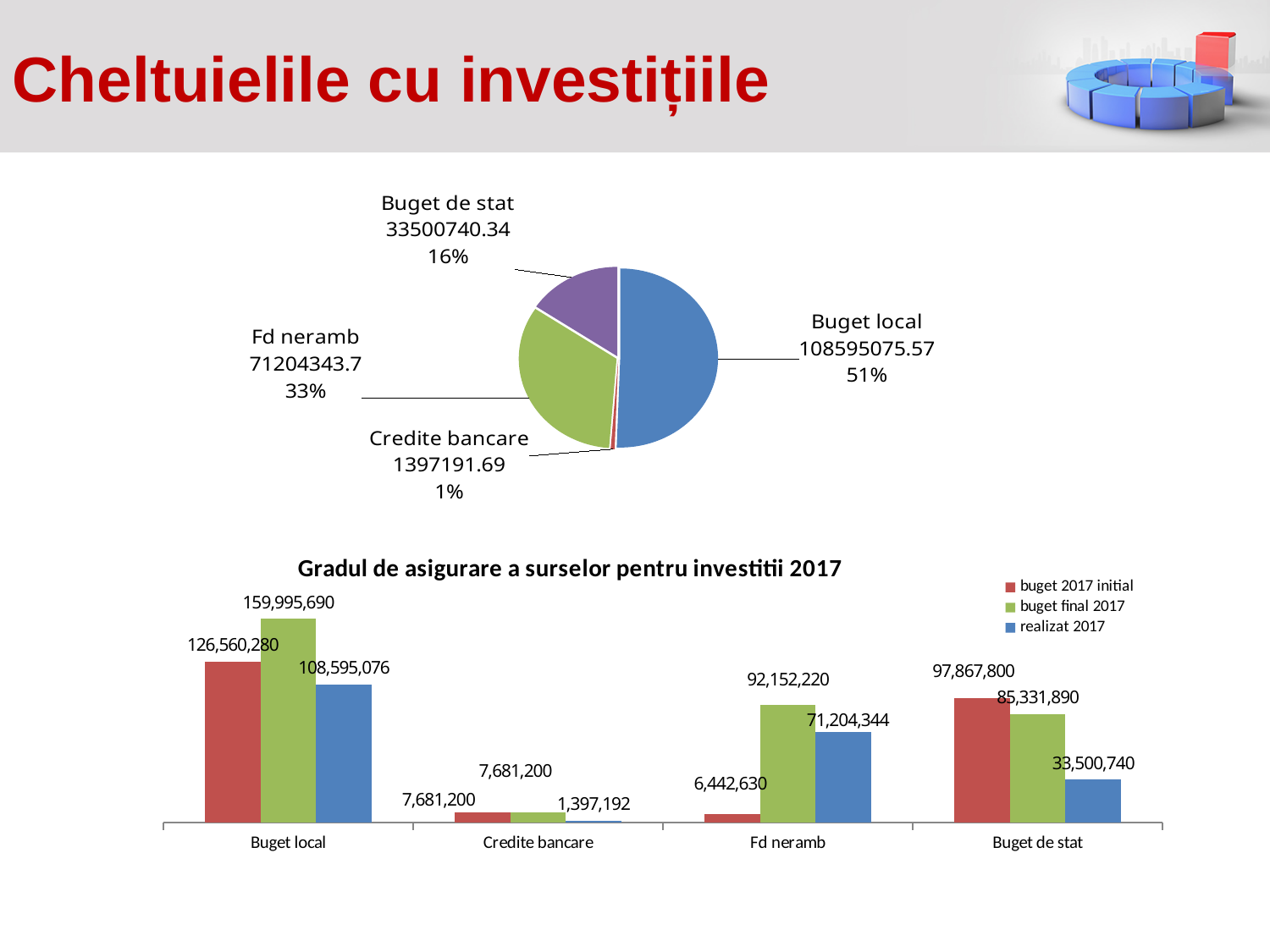
In the chart 'Gradul de asigurare a surselor pentru investitii 2017', what is the value of 'realizat 2017' for Fd neramb? 71,204,344 What kind of chart is 'Gradul de asigurare a surselor pentru investitii 2017'? bar chart In the pie chart at the top of the slide, what is the value for Buget local? 108595075.57 In the chart 'Gradul de asigurare a surselor pentru investitii 2017', what is the difference between 'buget final 2017' and 'realizat 2017' for Buget de stat? 51,831,150 In the pie chart at the top of the slide, what is the value for Buget de stat? 33500740.34 In the pie chart at the top of the slide, what share of the pie does Fd neramb represent? 33% In the chart 'Gradul de asigurare a surselor pentru investitii 2017', which category has the highest 'buget 2017 initial' value? Buget local In the pie chart at the top of the slide, how many slices are there? 4 In the chart 'Gradul de asigurare a surselor pentru investitii 2017', how many series does the legend list? 3 In the chart 'Gradul de asigurare a surselor pentru investitii 2017', which is larger for Fd neramb: 'buget 2017 initial' or 'buget final 2017'? buget final 2017 In the chart 'Gradul de asigurare a surselor pentru investitii 2017', what is the value of 'buget final 2017' for Buget local? 159,995,690 In the pie chart at the top of the slide, which category has the smallest slice? Credite bancare